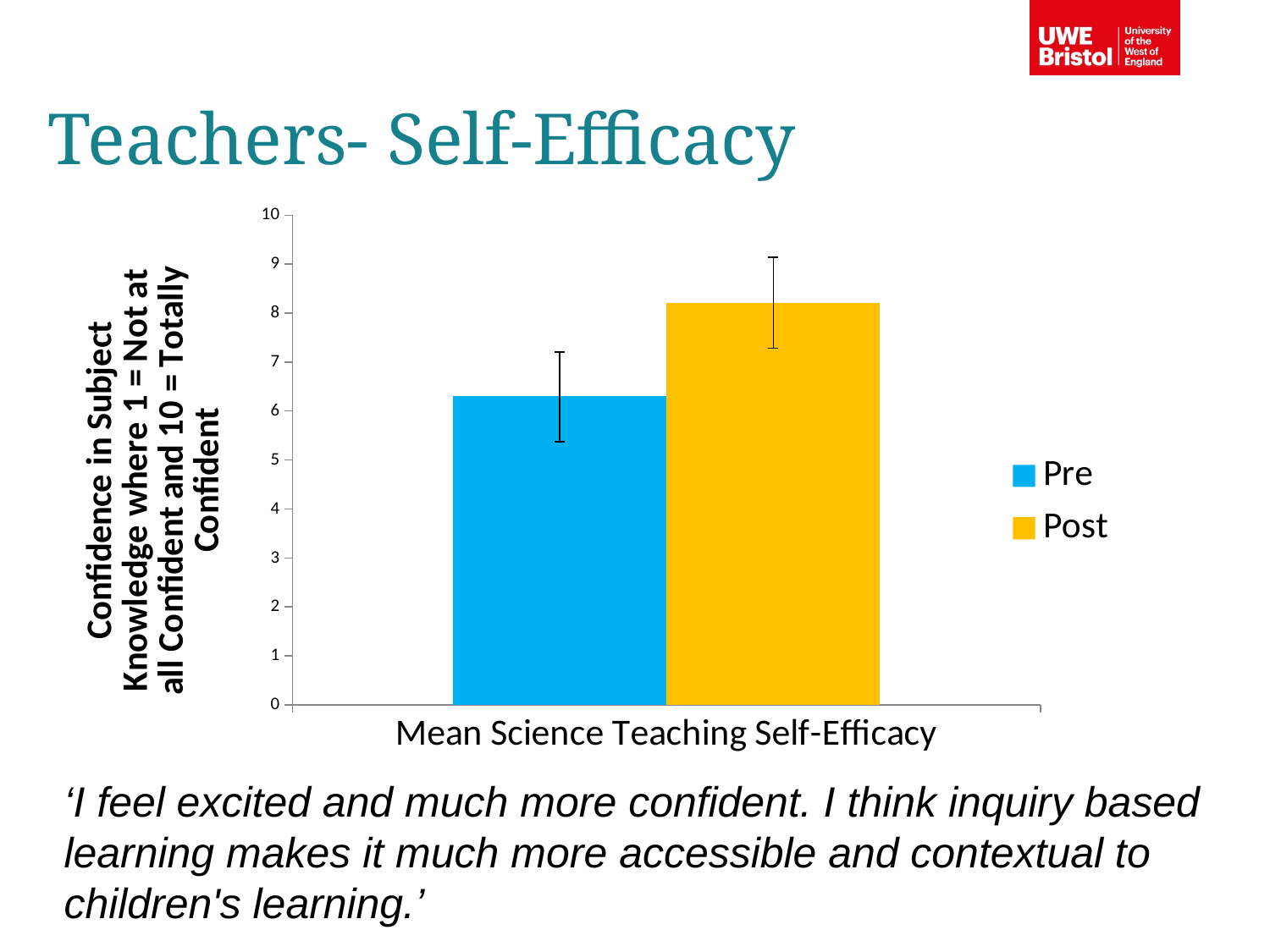
What is the label on the x axis of the chart? Mean Science Teaching Self-Efficacy Which series has the lowest bar? Pre How many series does the legend list? 2 What kind of chart is shown on the slide? Bar chart Is the value for Post greater or less than 7? greater How many categories are shown on the x axis? 1 Which series has the highest bar? Post Which series has the higher value, Pre or Post? Post Is the value for Pre greater or less than 6? greater Is the value for Pre greater or less than 7? less What colour is the Post series in the chart? Yellow